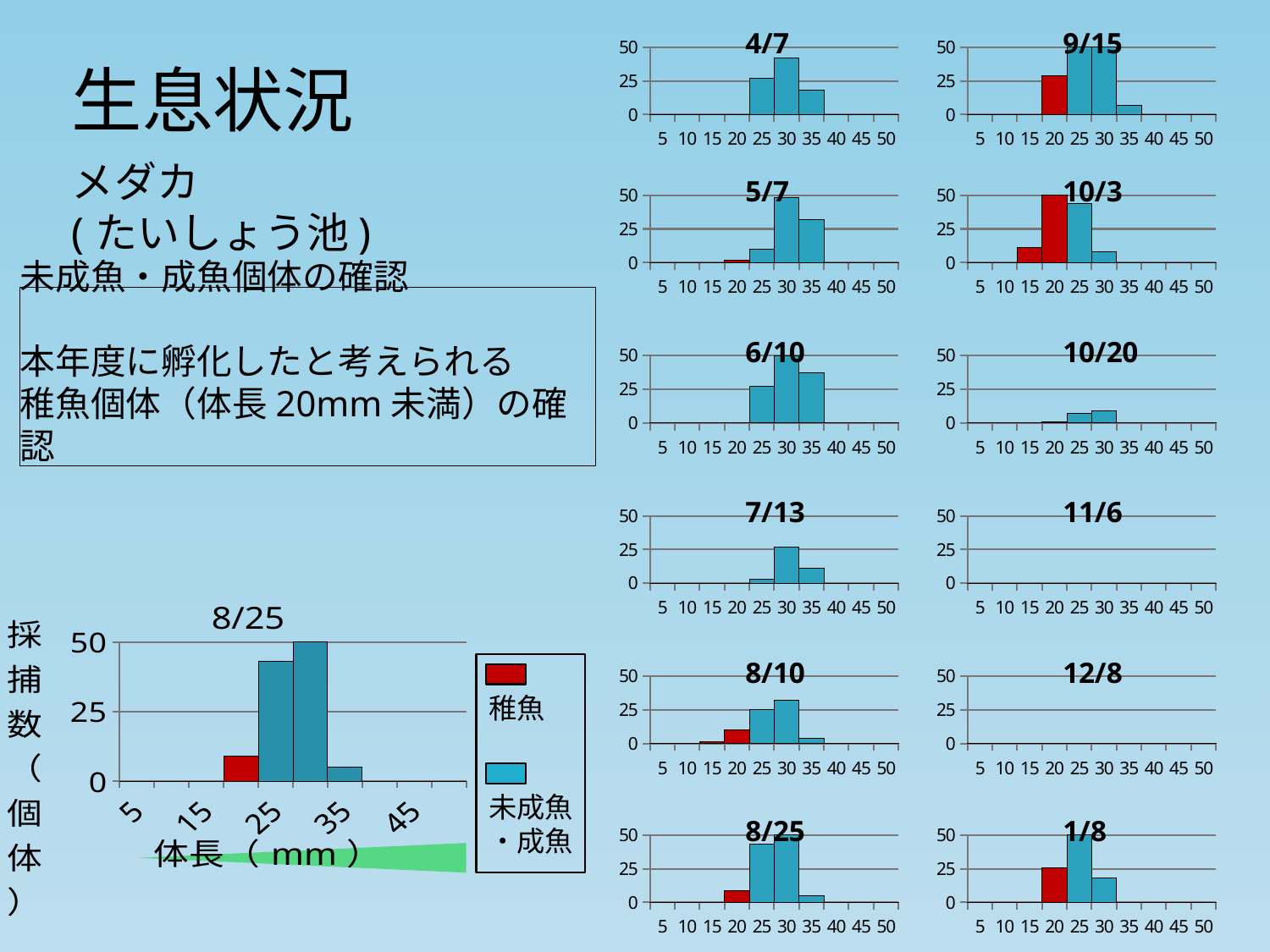
In the 7/13 chart, is the value for the 35 mm bin greater or less than 25? less In the large 8/25 chart, is the value for the red 20 mm bin greater or less than 25? less In the large 8/25 chart, which body-length bin has the highest catch count? 30 In the large 8/25 chart, is the value for the 25 mm bin greater or less than 25? greater What kind of chart is the large 8/25 chart at the bottom left of the slide? bar chart In the large 8/25 chart, which is larger, the value for the 25 mm bin or the 35 mm bin? 25 mm bin In the legend next to the large 8/25 chart, which series is shown in red? 稚魚 How many series does the legend next to the large 8/25 chart list? 2 How many small dated charts are shown on the right side of the slide? 12